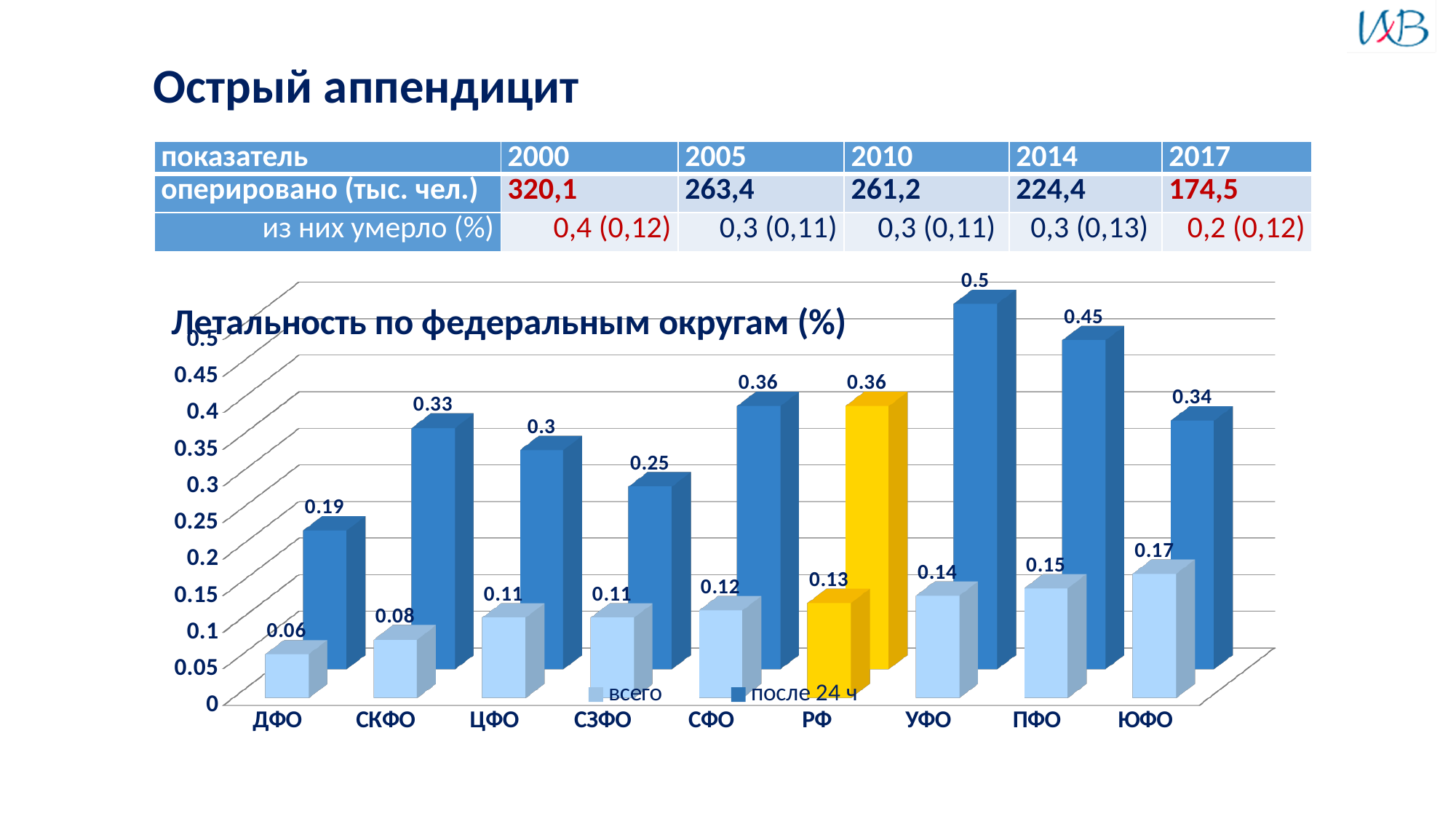
Do the "всего" values rise or fall from ДФО to ЮФО along the x axis? rise What is the difference between the "после 24 ч" and "всего" values for ПФО? 0.3 What kind of chart is shown on the slide? bar chart Which category has the lowest value for "всего"? ДФО What is the value for "после 24 ч" for УФО? 0.5 What is the title of the chart? Летальность по федеральным округам (%) How many series does the chart legend list? 2 What is the value for "всего" for ДФО? 0.06 Which category has the highest value for "после 24 ч"? УФО How many categories are shown on the x axis of the chart? 9 What is the value for "после 24 ч" for РФ? 0.36 Which is larger: the "после 24 ч" value for СКФО or for ЦФО? СКФО